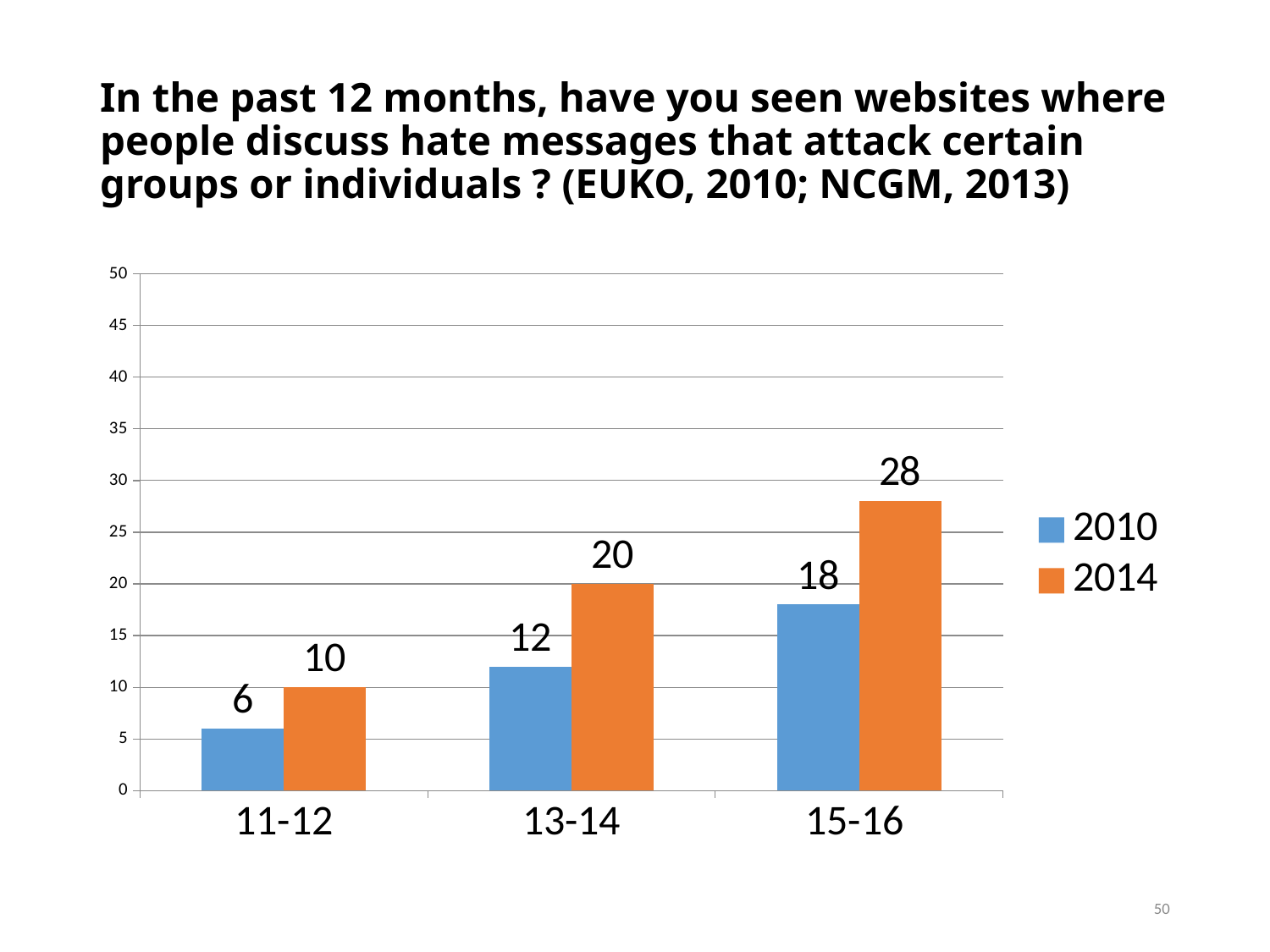
What is the value for the 2010 series in the 11-12 age group? 6 What is the difference between the 2014 and 2010 values for the 15-16 age group? 10 What is the value for the 2010 series in the 15-16 age group? 18 How many age groups are shown on the x axis? 3 Which age group has the highest value for the 2014 series? 15-16 Which colour represents the 2014 series in the legend? Orange What is the value for the 2014 series in the 13-14 age group? 20 Do the 2014 values rise or fall as the age group increases along the x axis? Rise How many series does the legend list? 2 Which age group has the lowest value for the 2010 series? 11-12 What kind of chart is shown on the slide? Bar chart Which is larger: the 2014 value for 11-12 or the 2010 value for 13-14? 2010 value for 13-14